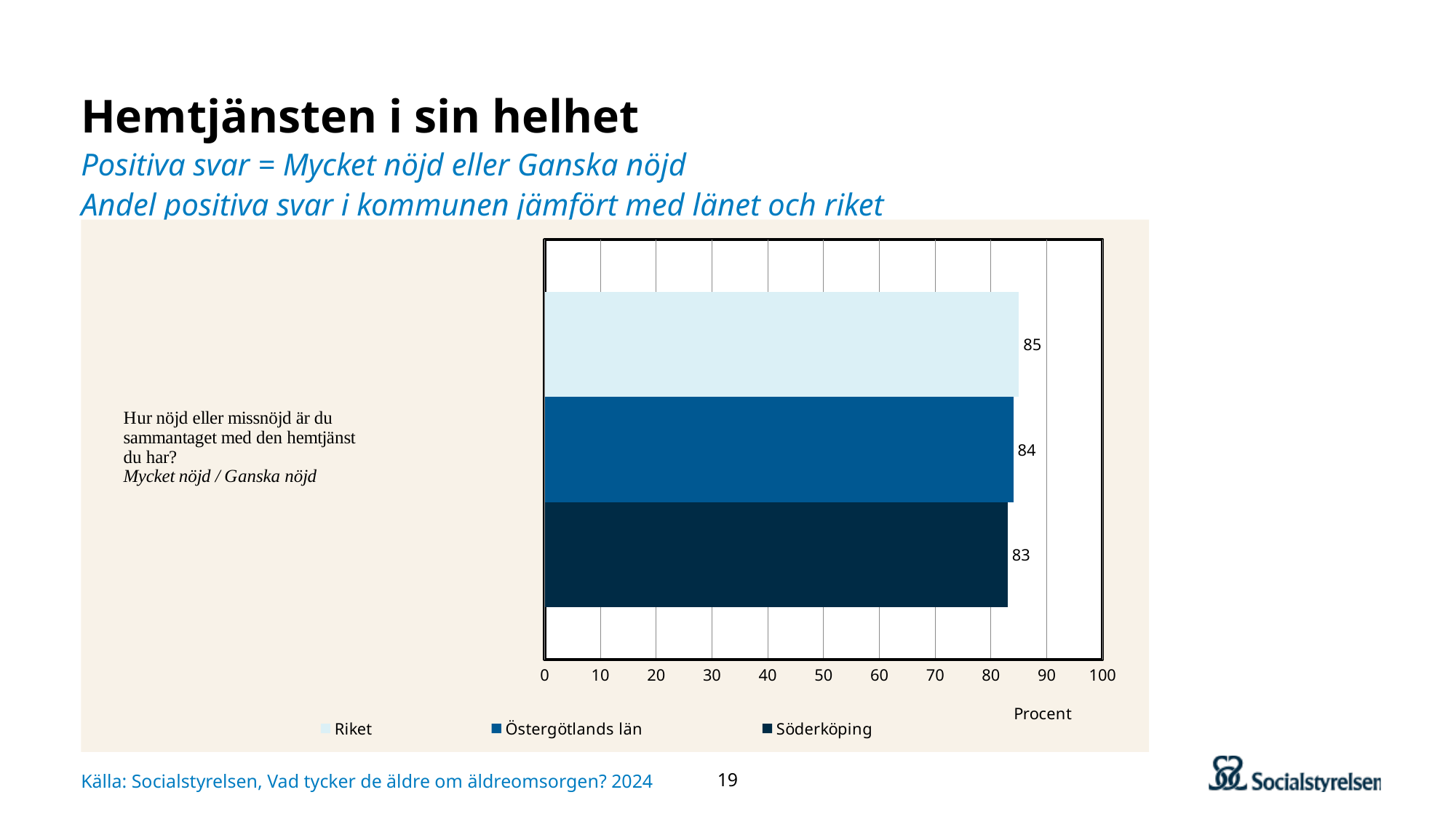
Which is larger, the value for Riket or the value for Söderköping? Riket Which series has the lowest value? Söderköping What is the value for Riket? 85 What kind of chart is shown on the slide? bar chart What is the difference between the values for Riket and Söderköping? 2 Is the value for Söderköping greater or less than 90? less How many series does the legend list? 3 What is the value for Östergötlands län? 84 What unit is shown on the x axis of the chart? Procent What is the difference between the values for Östergötlands län and Söderköping? 1 Which series has the highest value? Riket What is the value for Söderköping? 83